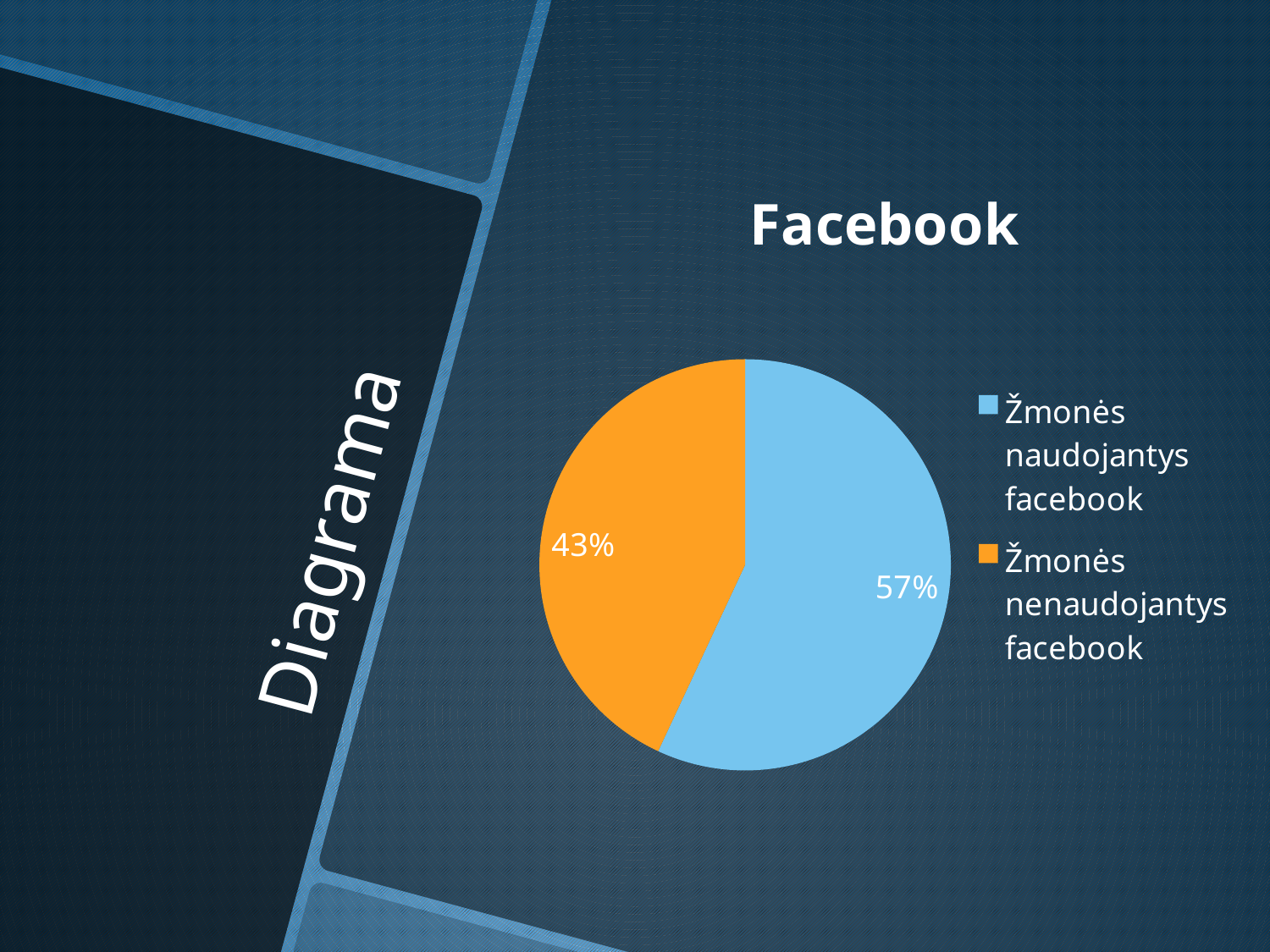
What is the difference in percentage points between the "Žmonės naudojantys facebook" slice and the "Žmonės nenaudojantys facebook" slice? 14 How many entries does the legend list? 2 What percentage of the pie is labelled for "Žmonės nenaudojantys facebook"? 43% What share of the pie does the "Žmonės naudojantys facebook" slice represent? 57% What colour is the slice for "Žmonės nenaudojantys facebook"? Orange Which is larger: the share for "Žmonės naudojantys facebook" or for "Žmonės nenaudojantys facebook"? Žmonės naudojantys facebook What type of chart is shown on the slide? Pie chart Which slice of the pie is the largest? Žmonės naudojantys facebook How many slices does the pie chart have? 2 Which slice of the pie is the smallest? Žmonės nenaudojantys facebook What percentage of the pie is labelled for "Žmonės naudojantys facebook"? 57% What is the title of the chart? Facebook